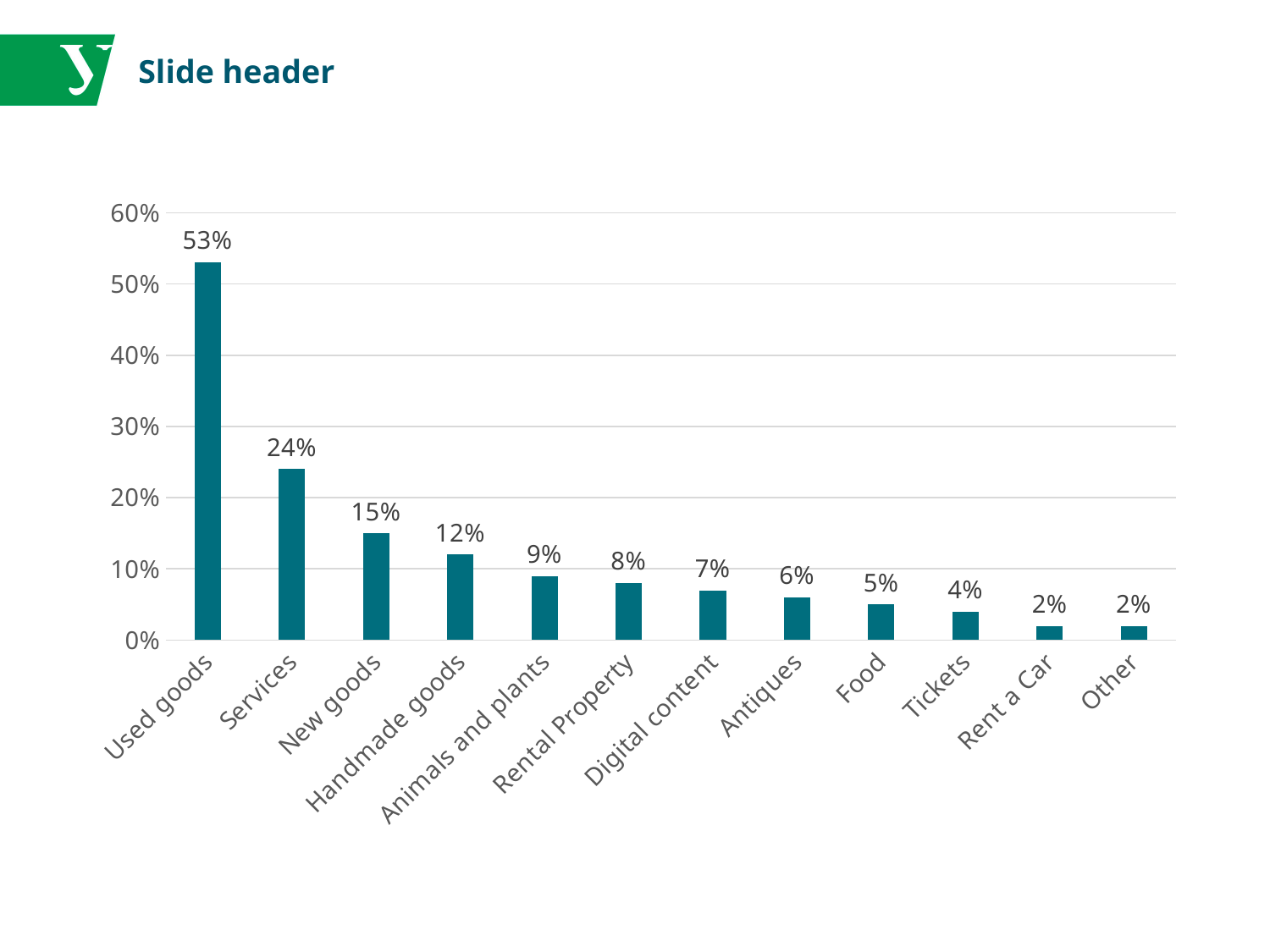
What is the value for Used goods? 53% Do the values rise or fall from left to right along the x axis? Fall What is the value for Digital content? 7% What is the highest value shown on the y axis? 60% What is the value for Handmade goods? 12% Which category has the highest value? Used goods Which is larger, the value for Antiques or the value for Food? Antiques What is the value for Tickets? 4% How many categories are shown on the x axis? 12 What is the difference between the values for Services and New goods? 9% What kind of chart is shown on the slide? Bar chart Is the value for Services greater or less than 20%? greater